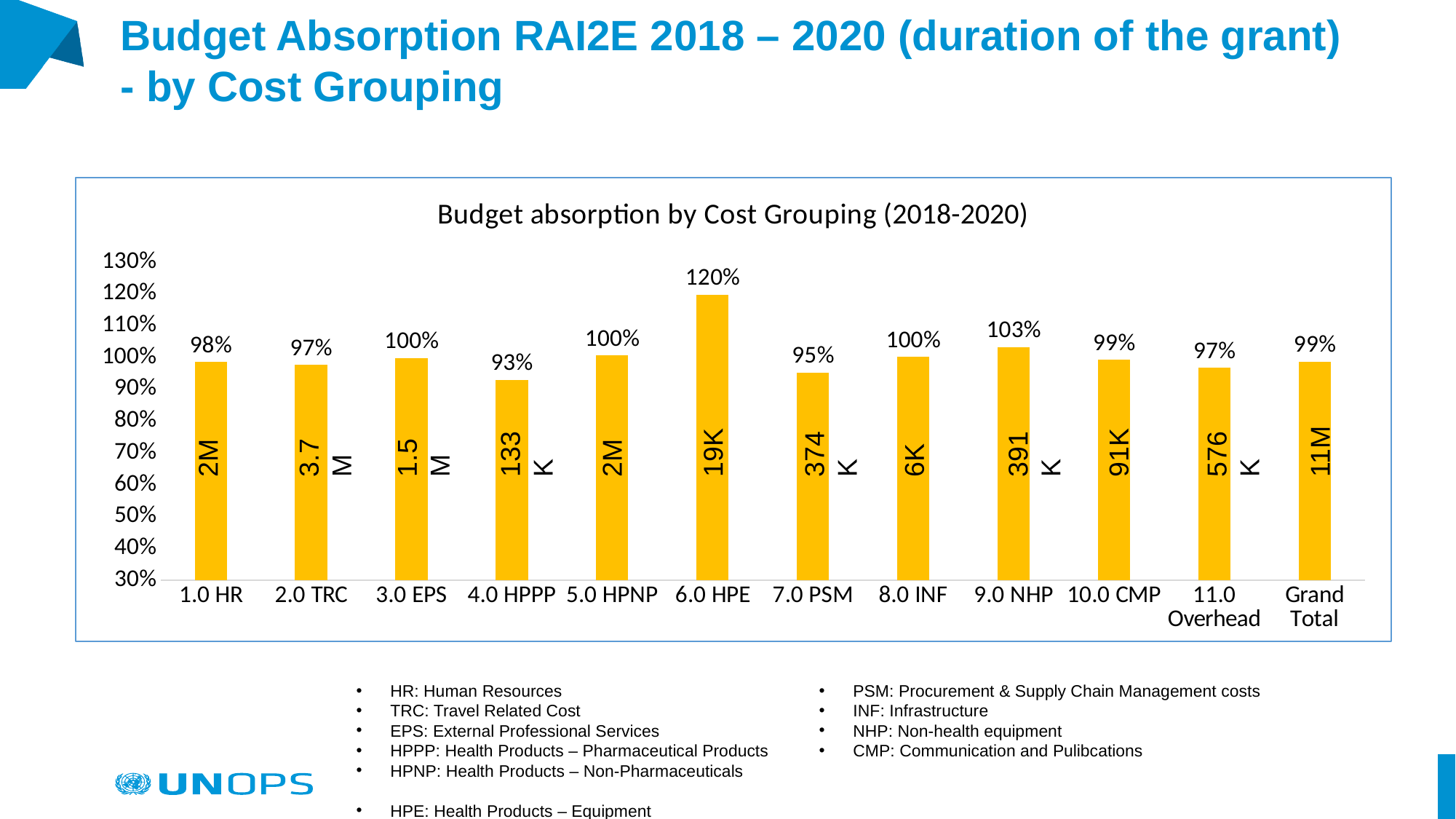
What is the budget absorption percentage for 4.0 HPPP? 93% What is the title of the chart? Budget absorption by Cost Grouping (2018-2020) What is the budget absorption percentage for 9.0 NHP? 103% Which has a higher budget absorption percentage, 1.0 HR or 7.0 PSM? 1.0 HR Is the budget absorption for 6.0 HPE greater or less than 110%? greater Which cost grouping has the highest budget absorption percentage? 6.0 HPE How many bars are shown in the chart? 12 What is the budget absorption percentage for the Grand Total? 99% What type of chart is shown on the slide? Bar chart Which cost grouping has the lowest budget absorption percentage? 4.0 HPPP What is the difference in budget absorption between 6.0 HPE and 4.0 HPPP? 27% What is the budget absorption percentage for 6.0 HPE? 120%